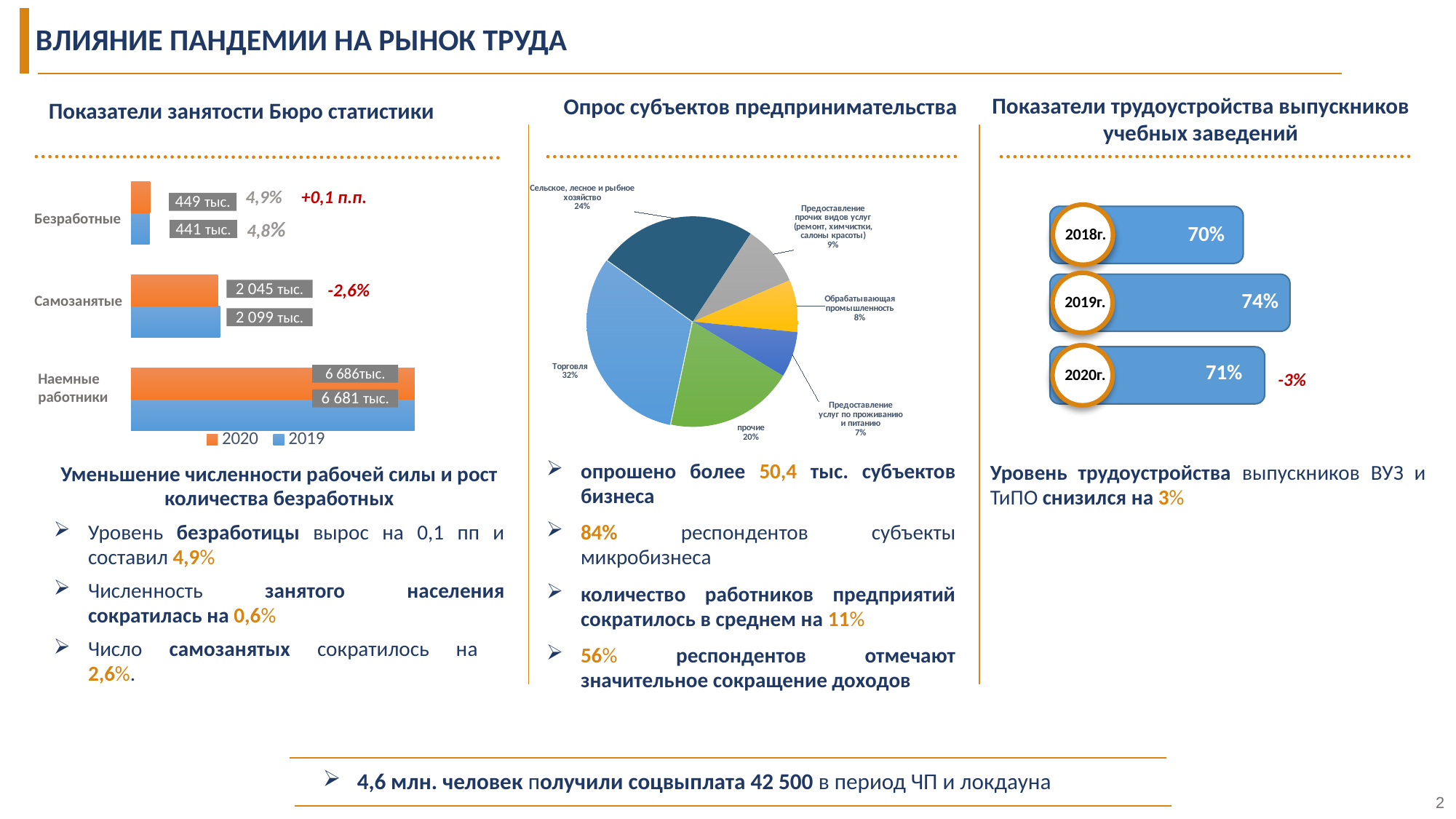
In the bar chart 'Показатели занятости Бюро статистики', which colour represents 2020? Orange In the bar chart 'Показатели занятости Бюро статистики', how many series does the legend list? 2 In the bar chart 'Показатели занятости Бюро статистики', what is the difference between the 2020 and 2019 values for Безработные? 8 тыс. In the bar chart 'Показатели занятости Бюро статистики', what is the 2020 value for Наемные работники? 6 686 тыс. In the bar chart 'Показатели занятости Бюро статистики', which category has the lowest values? Безработные In the bar chart 'Показатели занятости Бюро статистики', what is the 2019 value for Самозанятые? 2 099 тыс. In the pie chart 'Опрос субъектов предпринимательства', what share does Торговля have? 32% In the pie chart 'Опрос субъектов предпринимательства', how many slices are there? 6 In the pie chart 'Опрос субъектов предпринимательства', which slice is the smallest? Предоставление услуг по проживанию и питанию In the bar chart 'Показатели занятости Бюро статистики', which category has the highest values? Наемные работники What kind of chart is shown under 'Опрос субъектов предпринимательства'? Pie chart In the bar chart 'Показатели занятости Бюро статистики', what is the 2020 value for Безработные? 449 тыс.